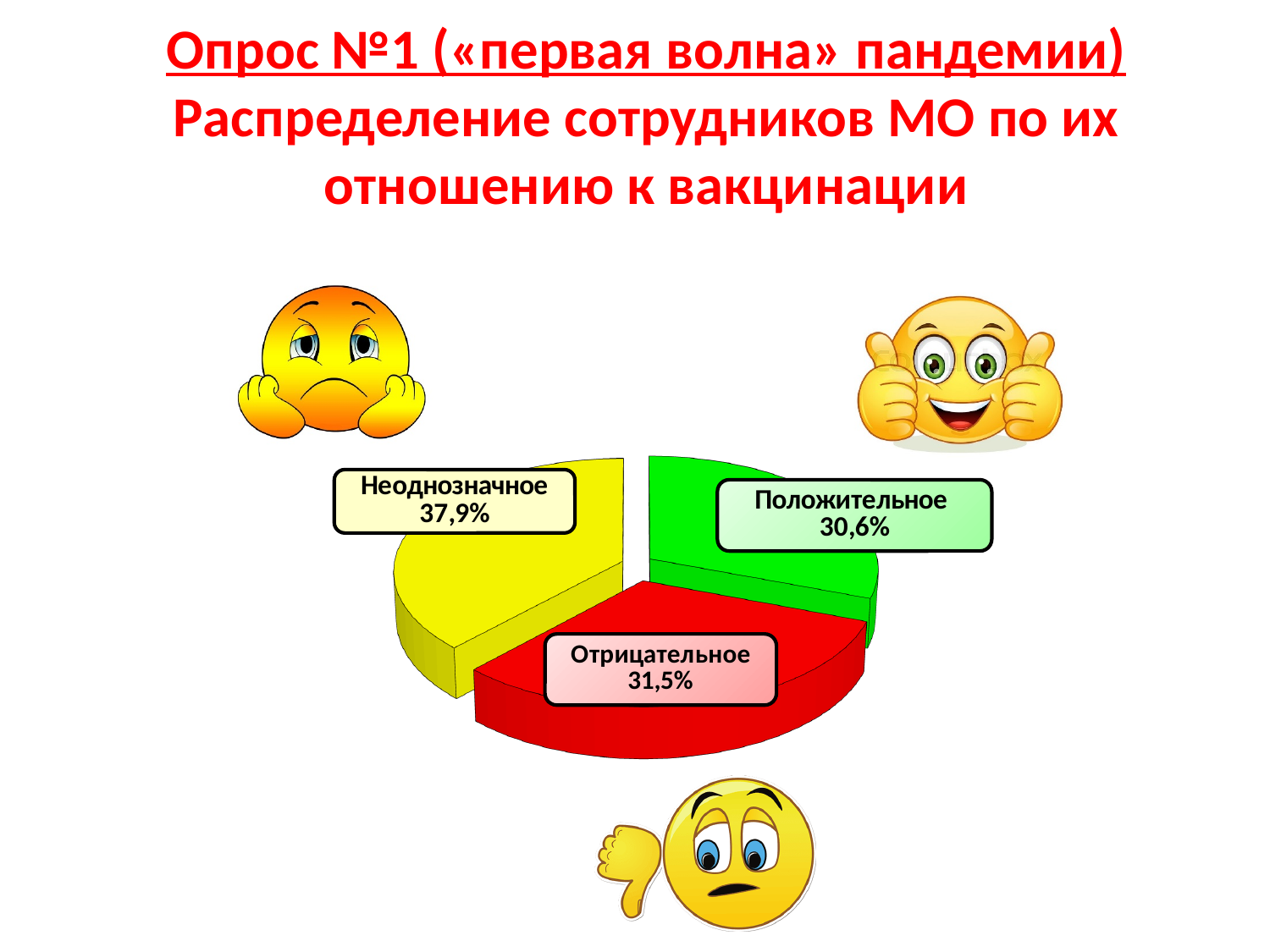
What is the difference in percentage points between the Отрицательное and Положительное slices? 0,9 What percentage of employees had a positive (Положительное) attitude toward vaccination? 30,6% What percentage of employees had an ambiguous (Неоднозначное) attitude toward vaccination? 37,9% What percentage of employees had a negative (Отрицательное) attitude toward vaccination? 31,5% What colour is the Отрицательное slice of the pie chart? Red What share of the pie does the Отрицательное slice represent? 31,5% How many categories does the pie chart show? 3 Which is larger, the Отрицательное slice or the Положительное slice? Отрицательное What is the difference in percentage points between the Неоднозначное and Положительное slices? 7,3 Which attitude category has the smallest share of the pie? Положительное What kind of chart is shown on the slide? Pie chart Which attitude category has the largest share of the pie? Неоднозначное